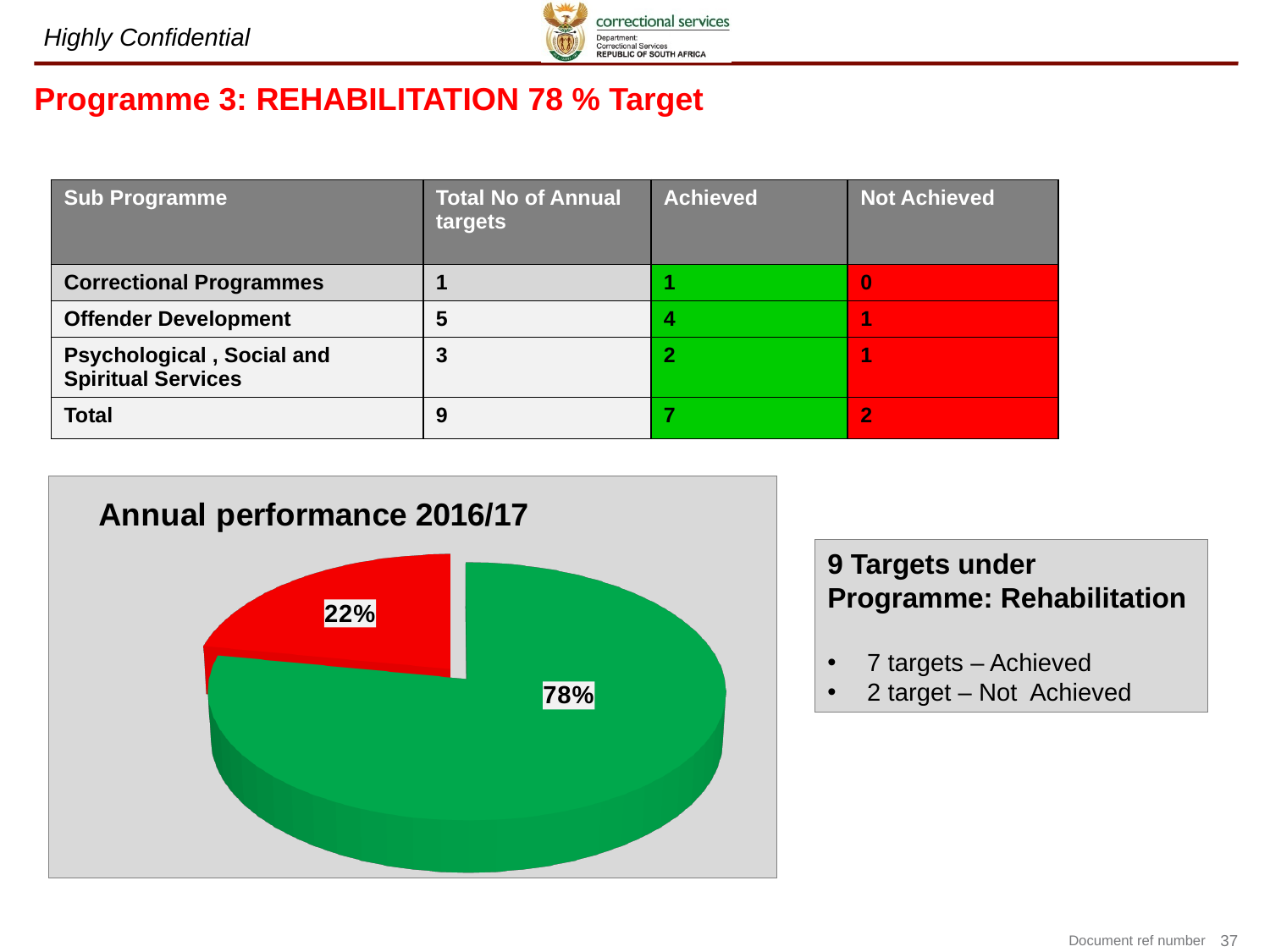
What do the two slices of the pie chart add up to? 100% What percentage is shown on the green slice of the pie chart? 78% Is the value of the red slice in the pie chart greater or less than 50%? less What percentage is shown on the red slice of the pie chart? 22% What share of the pie chart does the larger slice represent? 78% Which colour slice represents the smallest share of the pie chart? red Which slice of the pie chart is larger, the green one or the red one? green What type of chart is shown under the title "Annual performance 2016/17"? pie chart What is the difference in percentage points between the green slice and the red slice of the pie chart? 56 What is the title of the pie chart on the slide? Annual performance 2016/17 What colour is the slice labelled 78% in the pie chart? green How many slices does the pie chart have? 2